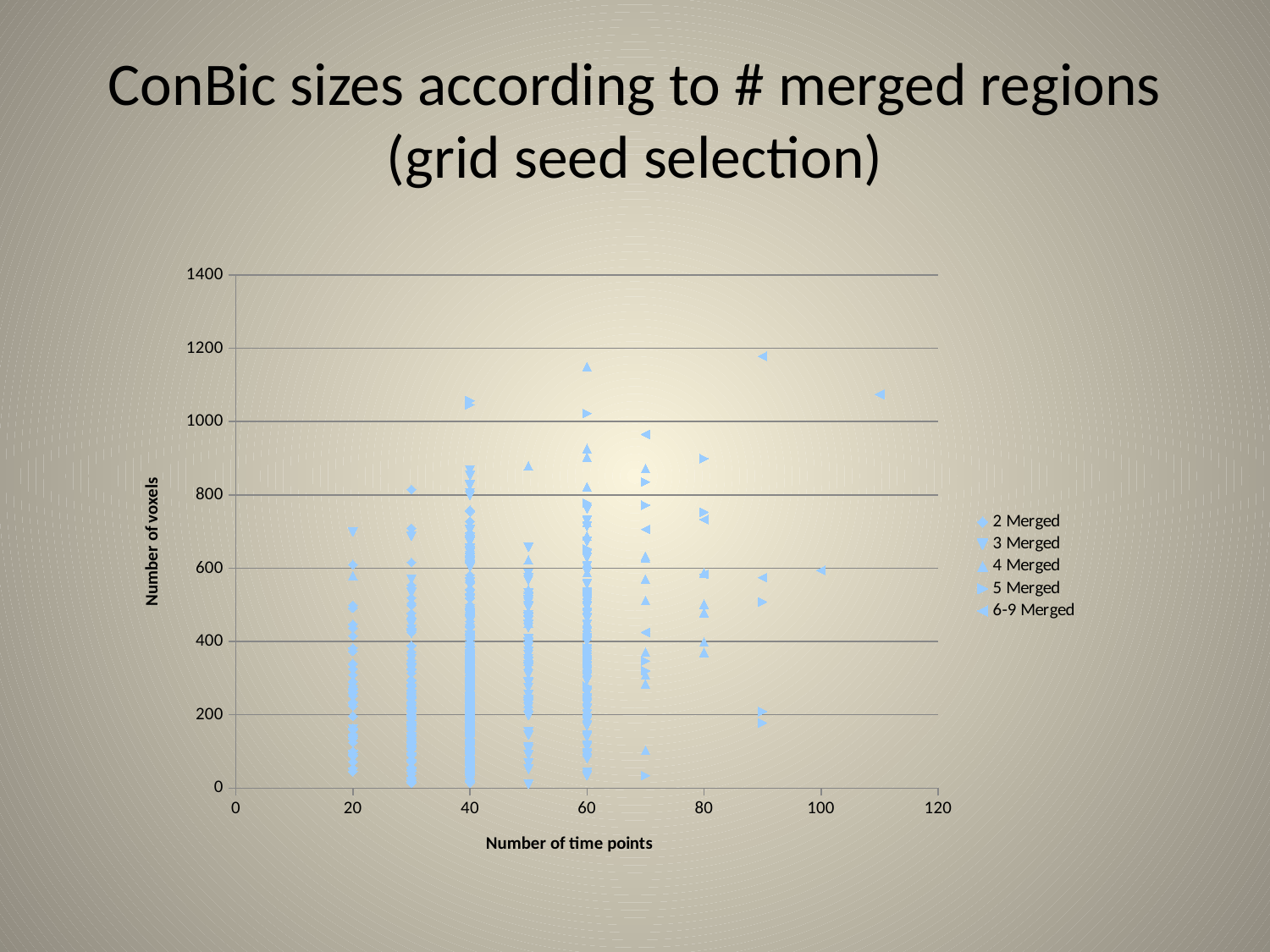
What kind of chart is shown on the slide? Scatter chart Is the highest point plotted at 40 time points greater or less than 800 voxels? greater What is the title of the vertical axis? Number of voxels Is the highest point plotted at 20 time points greater or less than 800 voxels? less What are the series names listed in the legend? 2 Merged, 3 Merged, 4 Merged, 5 Merged, 6-9 Merged Is the highest point plotted at 60 time points greater or less than 1000 voxels? greater What is the maximum value shown on the vertical axis? 1400 How many series does the legend list? 5